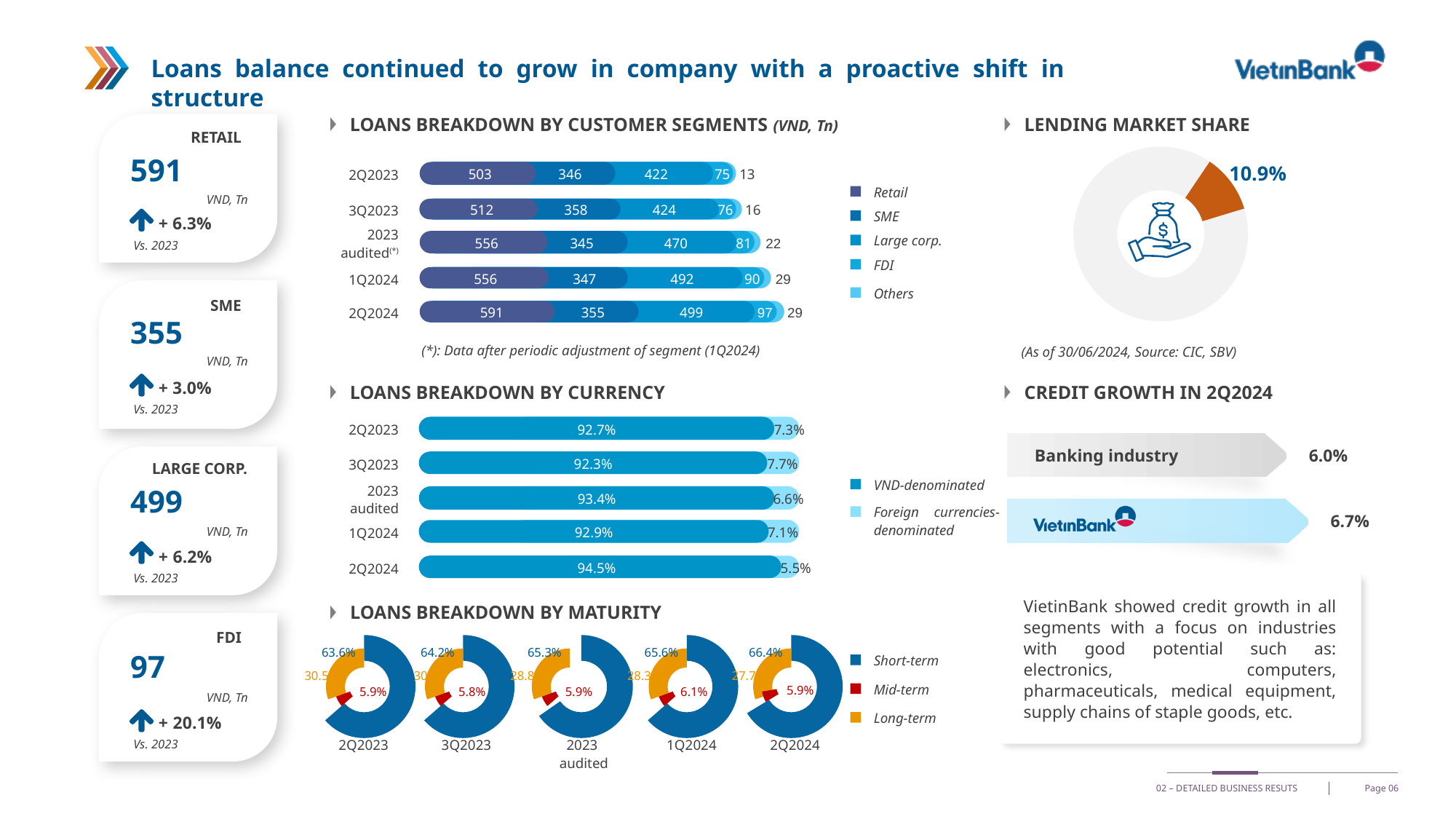
In the 'Loans breakdown by customer segments' chart, how much did the FDI value increase from 2Q2023 to 2Q2024? 22 In the 'Loans breakdown by customer segments' chart, what is the Retail value for 2Q2024? 591 In the 'Loans breakdown by customer segments' chart, what is the Large corp. value for 2023 audited? 470 In the 'Loans breakdown by maturity' chart, what is the Mid-term share for 2Q2024? 5.9% In the 'Loans breakdown by currency' chart, what is the VND-denominated share for 2Q2024? 94.5% In the 'Loans breakdown by currency' chart, how many periods are shown? 5 In the 'Loans breakdown by customer segments' chart, what is the total of the 2Q2024 stacked bar? 1,571 In the 'Loans breakdown by customer segments' chart, how many series does the legend list? 5 In the 'Loans breakdown by customer segments' chart, does the Retail value rise or fall from 2Q2023 to 2Q2024? Rise In the 'Loans breakdown by currency' chart, which period has the highest Foreign currencies-denominated share? 3Q2023 In the 'Lending market share' chart, what market share is shown for VietinBank? 10.9% In the 'Loans breakdown by maturity' chart, what is the Short-term share for 1Q2024? 65.6%